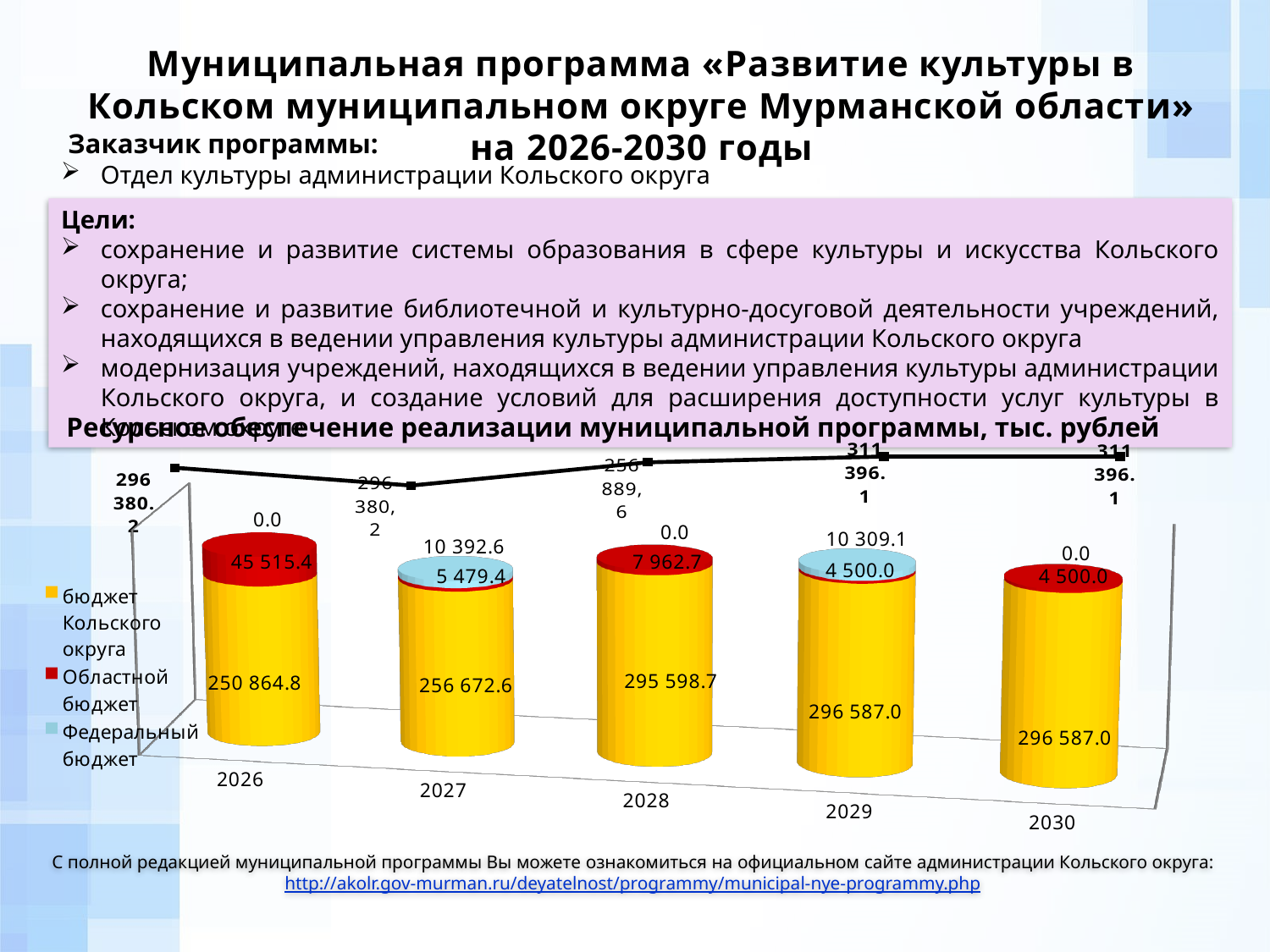
What is the value of бюджет Кольского округа for 2030? 296 587.0 How many years are shown on the x axis of the chart? 5 What is the difference between Областной бюджет in 2026 and in 2027? 40 036.0 What kind of chart is used to show the resource provision of the programme? Bar chart In which year is бюджет Кольского округа lowest? 2026 What is the value of Федеральный бюджет for 2027? 10 392.6 What is the value of Федеральный бюджет for 2029? 10 309.1 What is the value of Областной бюджет for 2026? 45 515.4 How many series does the chart legend list? 3 Which is larger: Областной бюджет in 2028 or in 2029? 2028 What is the value of бюджет Кольского округа for 2026? 250 864.8 In which year is Областной бюджет highest? 2026